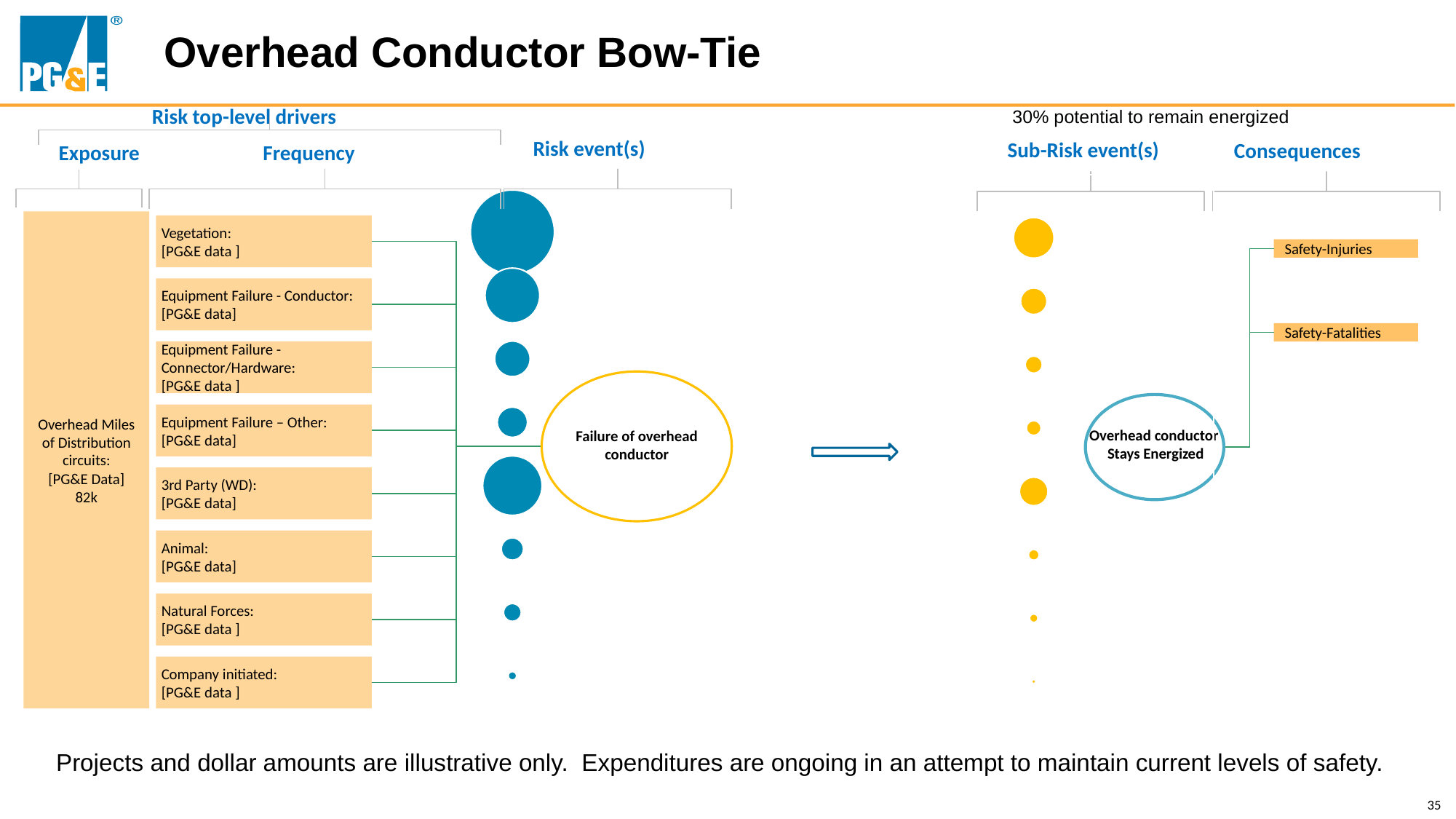
What exposure value is given for Overhead Miles of Distribution circuits? 82k Which has the larger blue bubble: Natural Forces or Company initiated? Natural Forces Which frequency driver has the smallest blue bubble in the Risk event(s) column? Company initiated Which frequency driver has the smallest yellow bubble in the Sub-Risk event(s) column? Company initiated What percentage potential to remain energized is stated above the Sub-Risk event(s) column? 30% What is the risk event shown in the centre of the bow-tie diagram? Failure of overhead conductor How many consequences are listed in the Consequences column? 2 How many frequency drivers are listed in the Frequency column of the bow-tie diagram? 8 What is the title of the slide? Overhead Conductor Bow-Tie Which has the larger blue bubble: Vegetation or Animal? Vegetation Which frequency driver has the largest yellow bubble in the Sub-Risk event(s) column? Vegetation Which frequency driver has the largest blue bubble in the Risk event(s) column? Vegetation